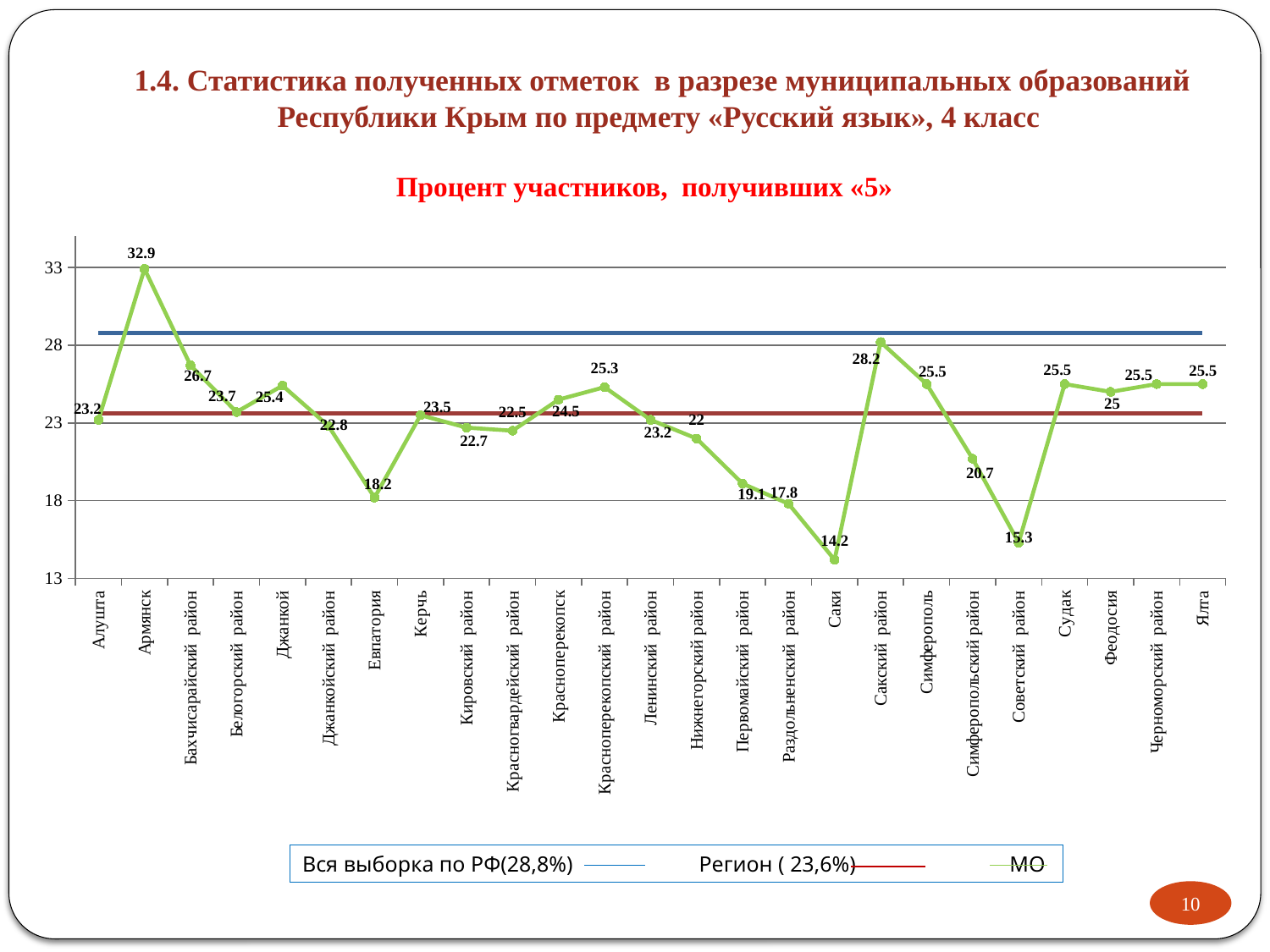
How many series does the legend list? 3 What is the value for Саки? 14.2 What kind of chart is shown? line chart Which is larger, the value for Джанкой or the value for Керчь? Джанкой Which municipality has the highest value? Армянск What is the value for Армянск? 32.9 Which municipality has the lowest value? Саки What is the value for Евпатория? 18.2 What is the difference between the values for Армянск and Саки? 18.7 Is the value for Советский район greater or less than 18? less What is the value for Сакский район? 28.2 How many municipalities are plotted on the x axis? 25